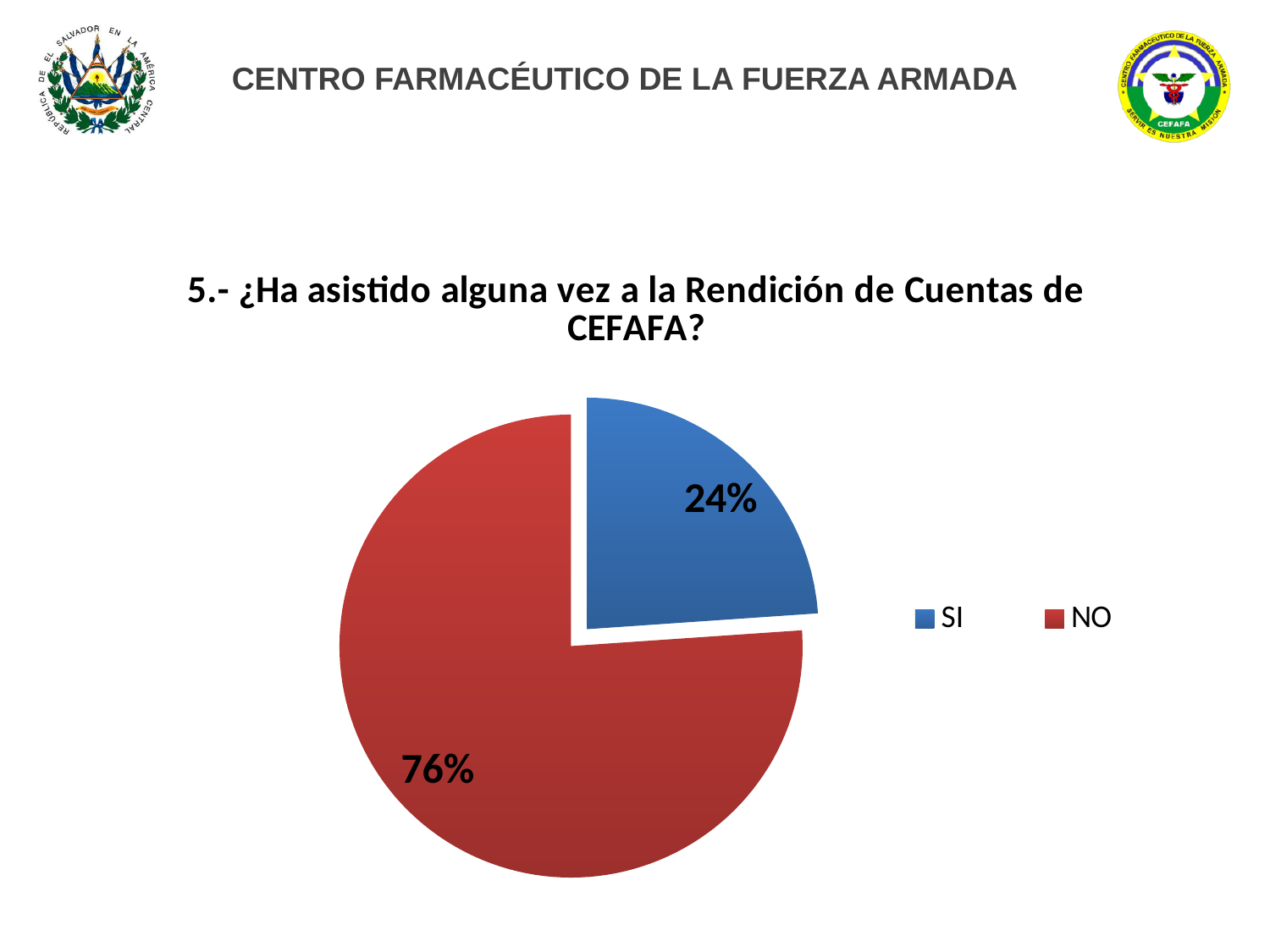
Which response has the largest share of the pie? NO What share of the pie does the SI slice represent? 24% What percentage of respondents answered NO? 76% How many slices does the pie chart have? 2 What is the title of the chart? 5.- ¿Ha asistido alguna vez a la Rendición de Cuentas de CEFAFA? Which response has the smallest share of the pie? SI Which is larger, the SI slice or the NO slice? NO What kind of chart is shown on the slide? pie chart What is the difference in percentage points between the NO and SI slices? 52 How many entries does the legend list? 2 What percentage of respondents answered SI? 24% What colour is the NO slice? red